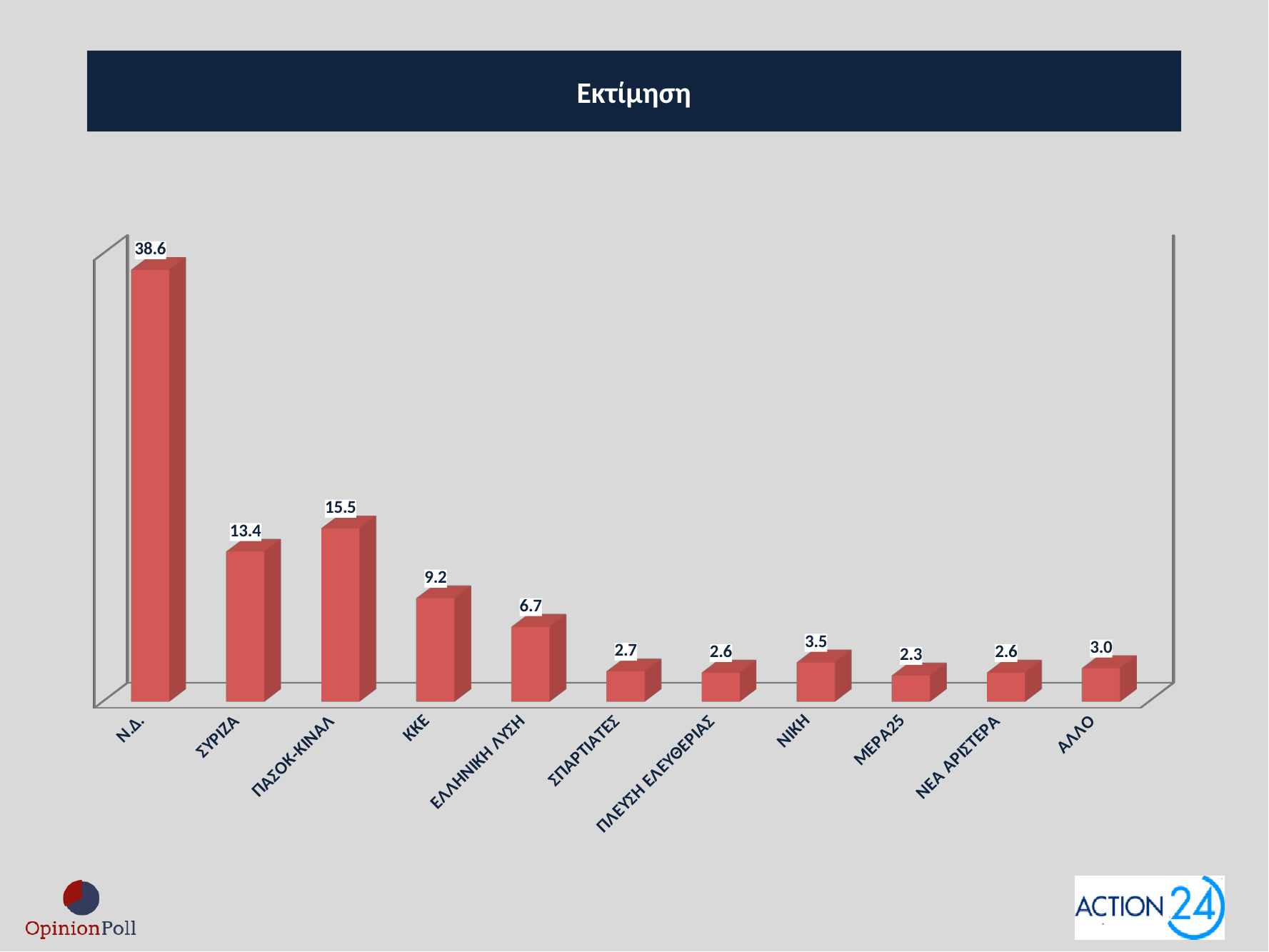
Which is larger, the value for ΣΥΡΙΖΑ or the value for ΠΑΣΟΚ-ΚΙΝΑΛ? ΠΑΣΟΚ-ΚΙΝΑΛ What is the value for Ν.Δ.? 38.6 What is the title of the chart? Εκτίμηση Which category has the highest value? Ν.Δ. What kind of chart is shown on the slide? Bar chart What is the difference between the values for ΣΥΡΙΖΑ and ΚΚΕ? 4.2 How many categories are shown on the chart? 11 What is the difference between the values for Ν.Δ. and ΠΑΣΟΚ-ΚΙΝΑΛ? 23.1 What is the value for ΠΑΣΟΚ-ΚΙΝΑΛ? 15.5 Which category has the lowest value? ΜΕΡΑ25 What is the value for ΝΙΚΗ? 3.5 What is the value for ΕΛΛΗΝΙΚΗ ΛΥΣΗ? 6.7